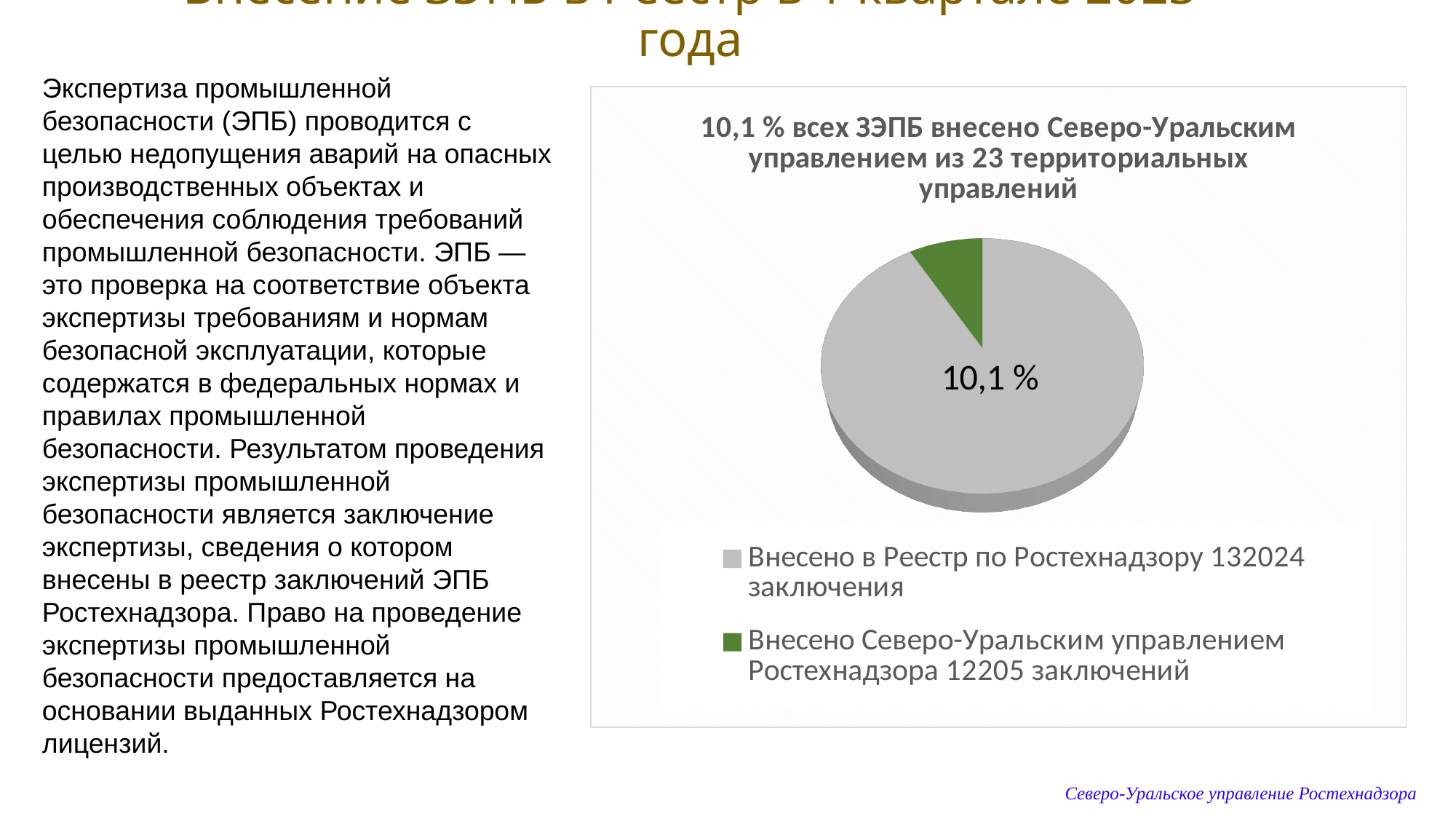
According to the chart title, out of how many территориальных управлений is the Северо-Уральское управление counted? 23 How many заключений are given in the legend for 'Внесено Северо-Уральским управлением Ростехнадзора'? 12205 Which slice of the pie chart is the largest? Внесено в Реестр по Ростехнадзору Which is larger: the number for 'Внесено в Реестр по Ростехнадзору' or for 'Внесено Северо-Уральским управлением Ростехнадзора'? Внесено в Реестр по Ростехнадзору What kind of chart is shown on the slide? pie chart What share of the pie is labelled for the slice 'Внесено Северо-Уральским управлением Ростехнадзора'? 10,1 % How many entries does the legend of the pie chart list? 2 How many заключения are given in the legend for 'Внесено в Реестр по Ростехнадзору'? 132024 What is the difference between 132024 and 12205, the two numbers given in the legend? 119819 What colour is the slice for 'Внесено Северо-Уральским управлением Ростехнадзора'? green How many slices does the pie chart have? 2 Which slice of the pie chart is the smallest? Внесено Северо-Уральским управлением Ростехнадзора